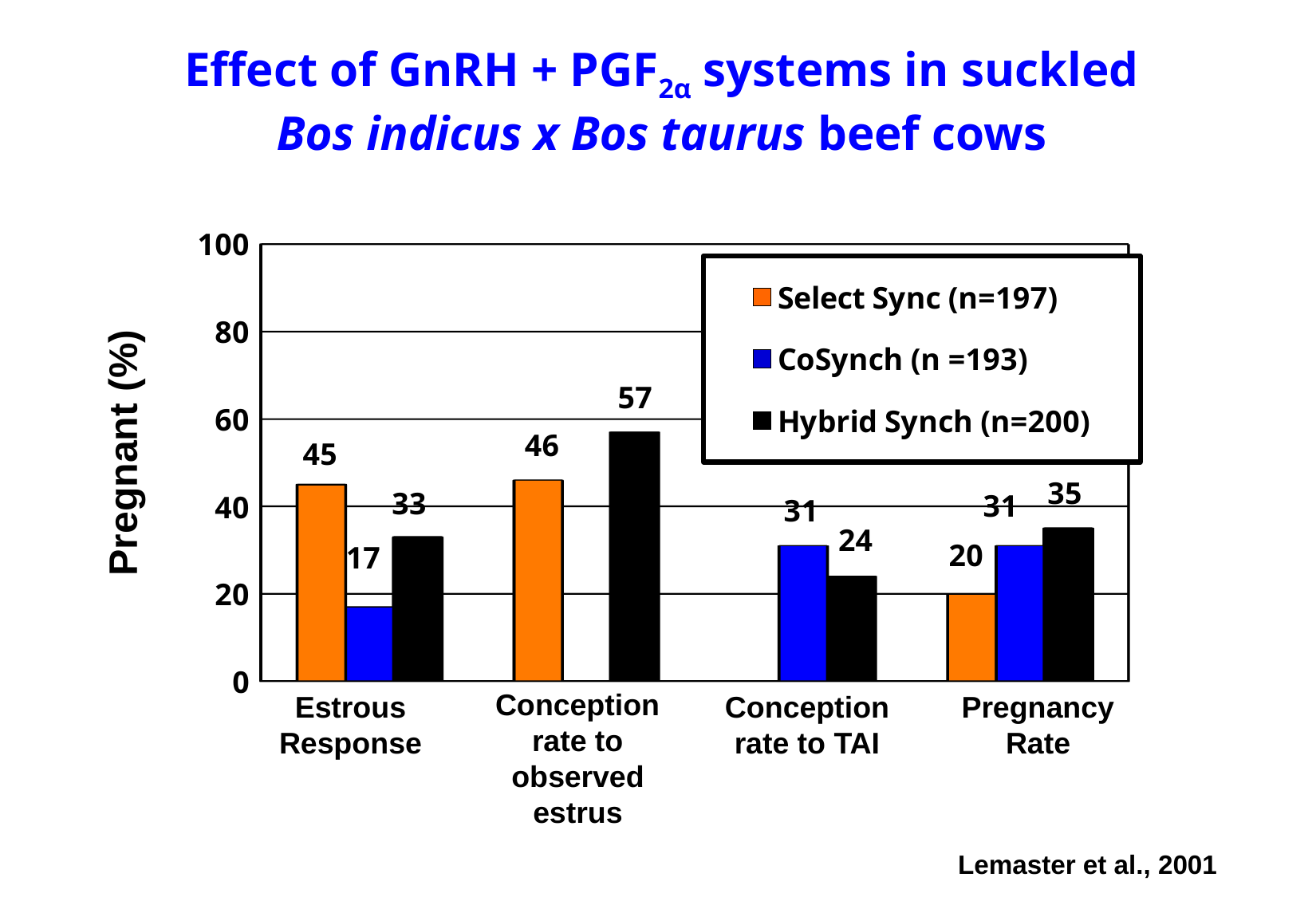
Which system has the highest Pregnancy Rate? Hybrid Synch How many series does the legend list? 3 What is the label of the y axis? Pregnant (%) What is the difference between the Select Sync and CoSynch Estrous Response values? 28 What is the Conception rate to TAI for Hybrid Synch? 24 Which is larger, the Conception rate to TAI for CoSynch or for Hybrid Synch? CoSynch Which system has the lowest Estrous Response? CoSynch What kind of chart is shown on the slide? Bar chart What is the Pregnancy Rate for CoSynch? 31 What is the Conception rate to observed estrus for Hybrid Synch? 57 What is the Estrous Response value for Select Sync? 45 How many categories are shown on the x axis? 4